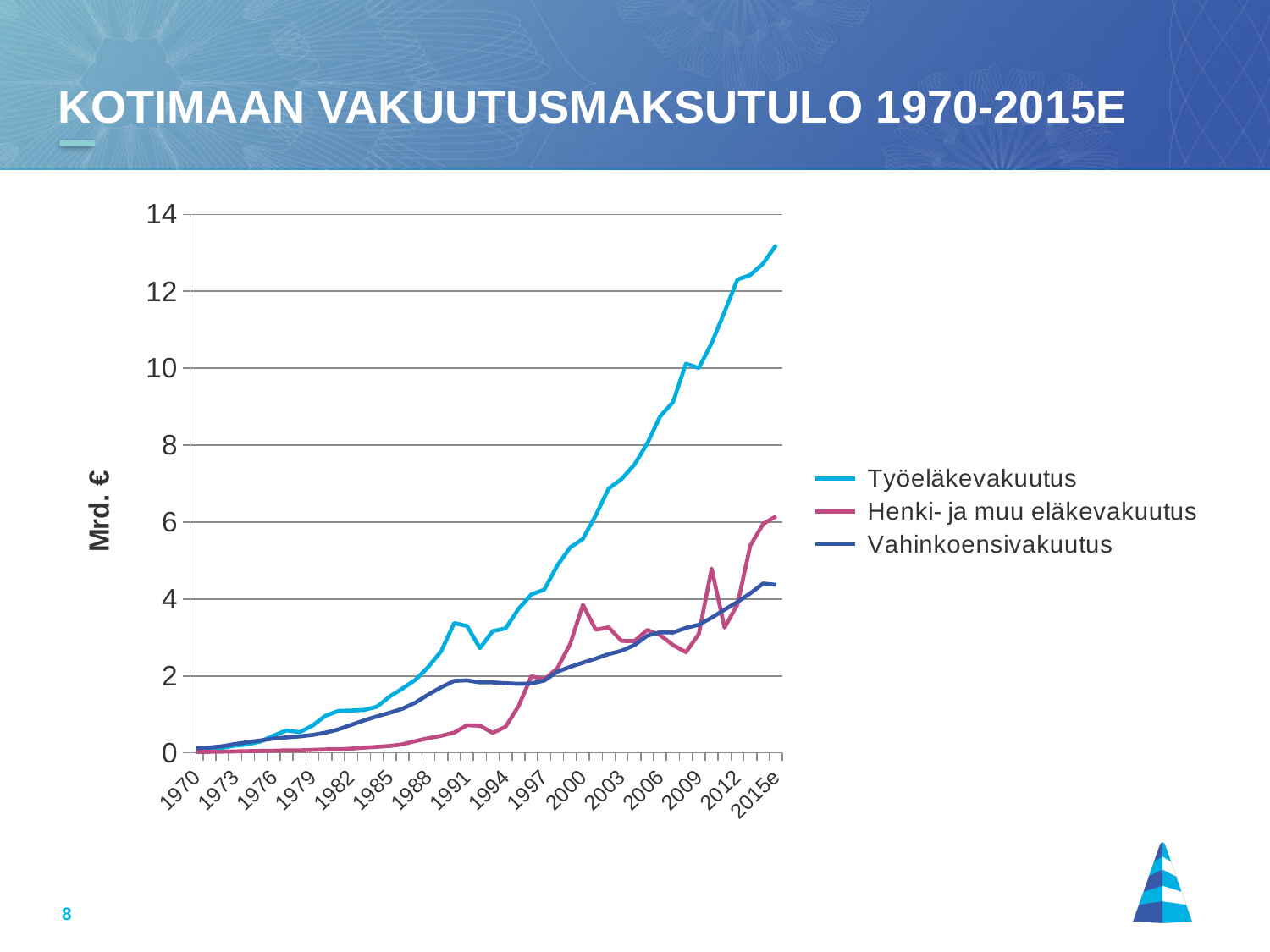
Which series has the lowest value at 2015e? Vahinkoensivakuutus What is the title of the chart on the slide? KOTIMAAN VAKUUTUSMAKSUTULO 1970-2015E What kind of chart is shown on the slide? line chart Is the value for Henki- ja muu eläkevakuutus at 2015e greater or less than 4? greater Is the value for Vahinkoensivakuutus at 2015e greater or less than 6? less Is the value for Työeläkevakuutus at 2015e greater or less than 12? greater Does the Työeläkevakuutus series generally rise or fall from 1970 to 2015e? rise Which series has the highest value at 2015e? Työeläkevakuutus How many series does the legend list? 3 What is the label on the vertical axis? Mrd. € In 1991, which is larger: Vahinkoensivakuutus or Henki- ja muu eläkevakuutus? Vahinkoensivakuutus